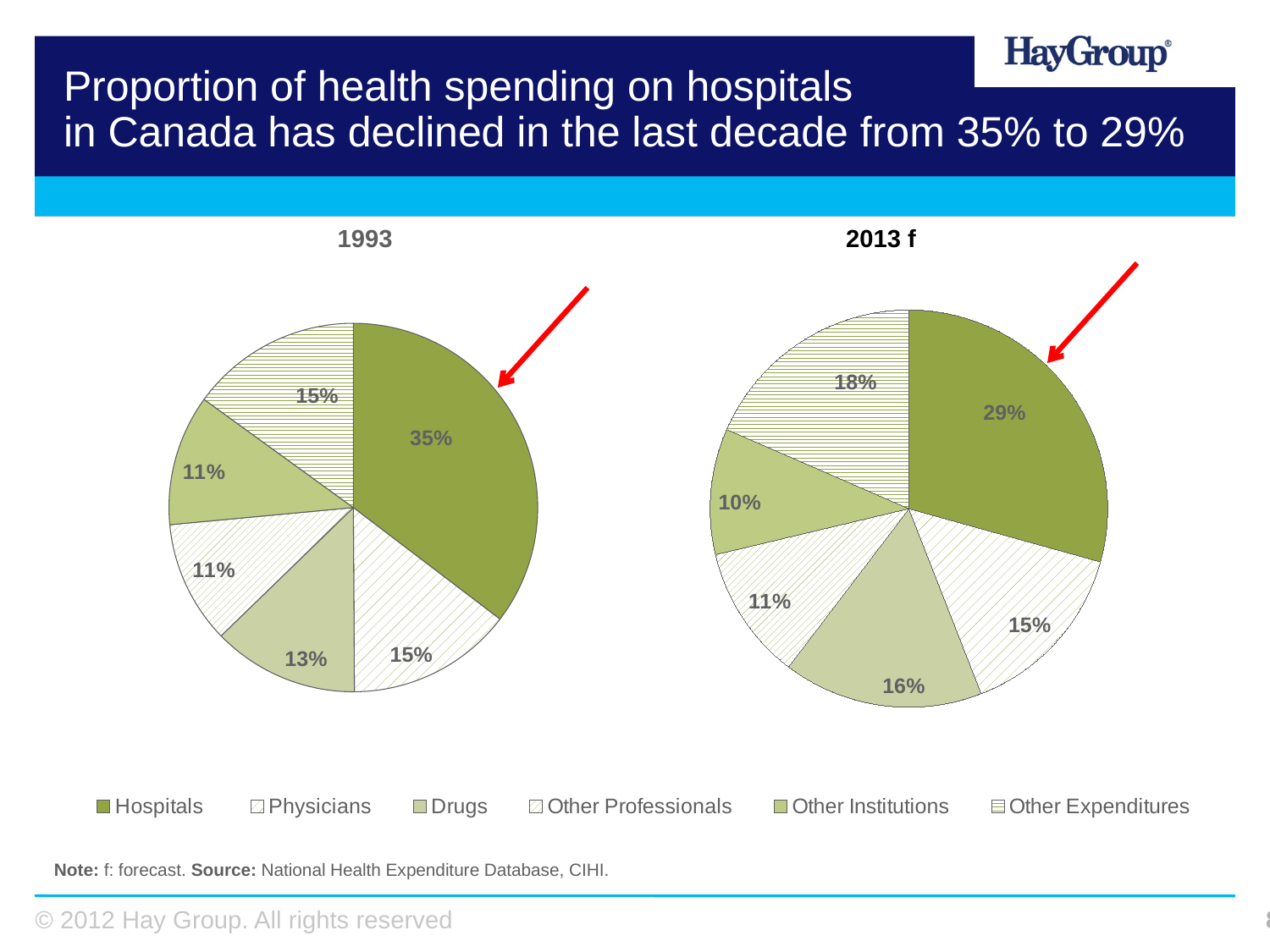
In the 2013 f pie chart, which is larger: the share for Drugs or the share for Physicians? Drugs In the 2013 f pie chart, which category has the smallest share? Other Institutions In the 2013 f pie chart, what is the share for Other Expenditures? 18% In the 2013 f pie chart, what share of health spending went to Hospitals? 29% What type of chart is used for the 1993 and 2013 f data? Pie chart How many slices does the 1993 pie chart have? 6 In the 2013 f pie chart, what is the share for Drugs? 16% In the 1993 pie chart, which category has the largest share? Hospitals How many categories does the legend list? 6 In the 1993 pie chart, what share of health spending went to Hospitals? 35% In the 1993 pie chart, what is the share for Drugs? 13% By how many percentage points did the Hospitals share fall from the 1993 pie chart to the 2013 f pie chart? 6 percentage points